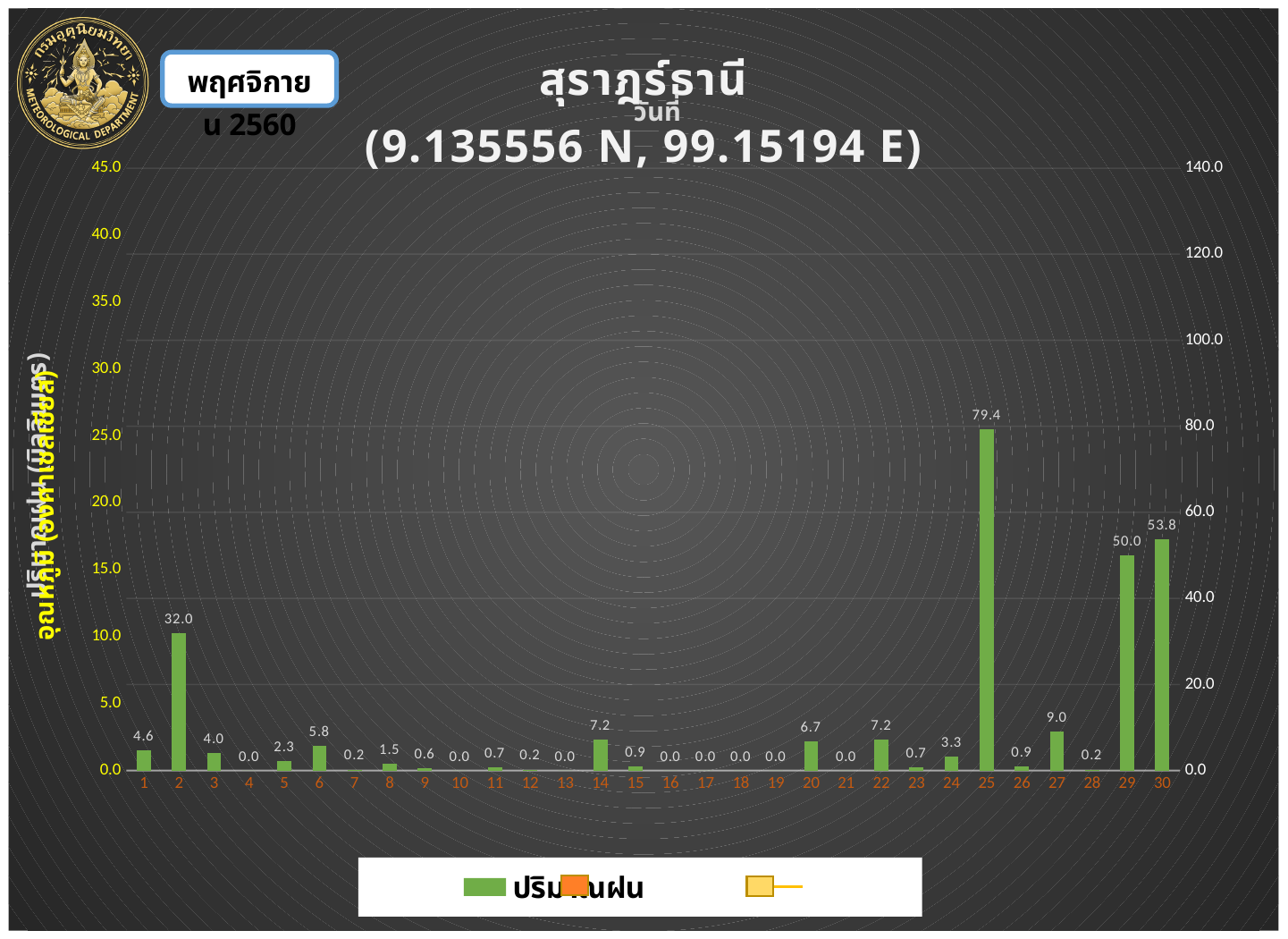
Which day has the highest rainfall bar? 25 Is the rainfall value for day 29 greater or less than 40.0 on the right axis? greater Which is larger, the rainfall value for day 27 or for day 20? day 27 What kind of chart is shown on the slide? bar chart What is the rainfall value shown for day 30? 53.8 How many days are shown on the x axis of the chart? 30 What colour are the rainfall (ปริมาณฝน) bars in the chart? green What is the difference between the rainfall values for day 25 and day 2? 47.4 What is the rainfall value shown for day 14? 7.2 What is the rainfall value shown for day 25? 79.4 What is the rainfall value shown for day 2? 32.0 What is the difference between the rainfall values for day 30 and day 29? 3.8